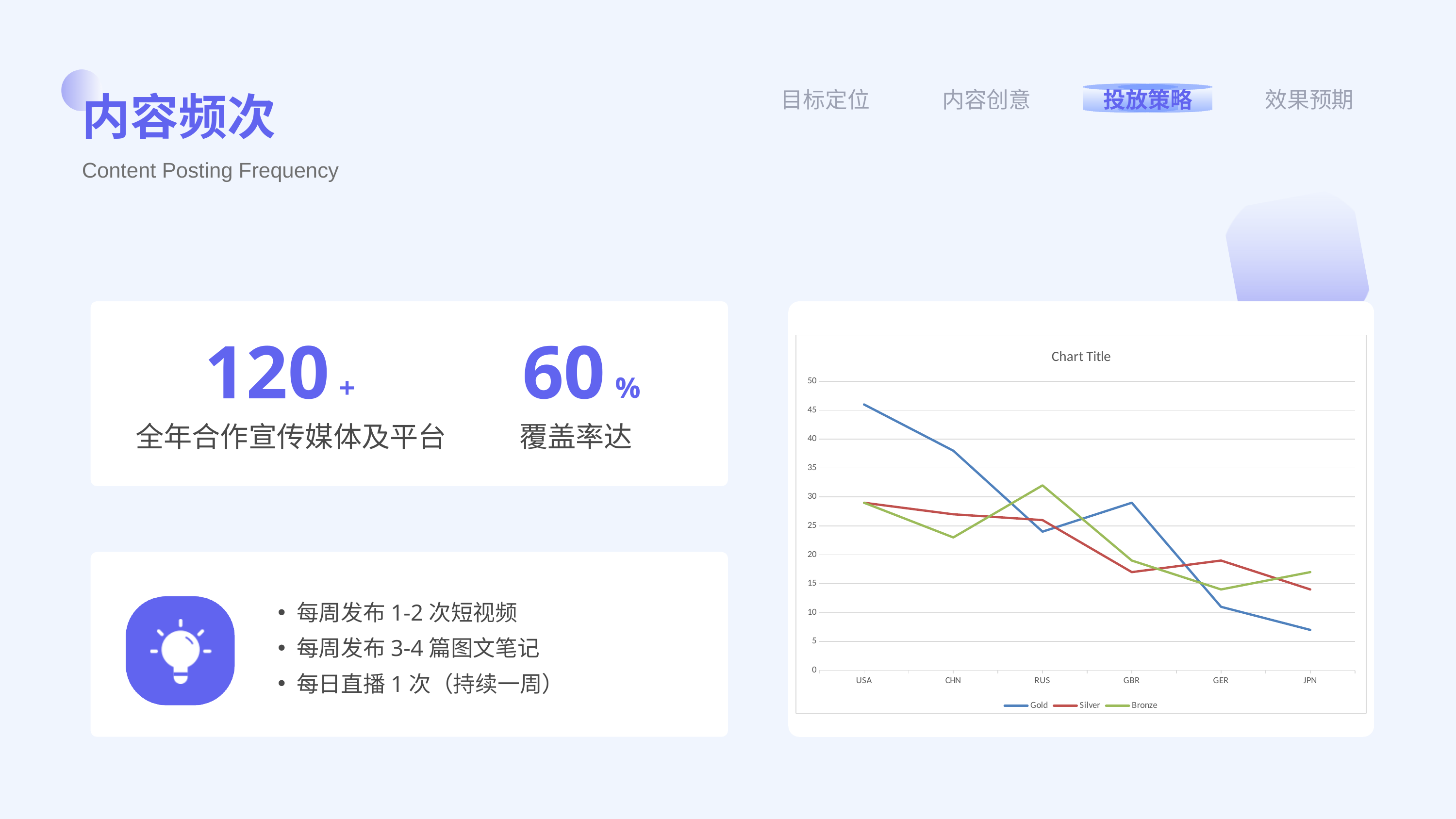
Does the Gold line generally rise or fall from USA to JPN? fall Is the Gold value for USA greater or less than 40? greater Which category has the highest Bronze value? RUS Which category has the lowest Gold value? JPN Is the Bronze value for RUS greater or less than 30? greater How many categories are shown on the x axis of the chart? 6 What kind of chart is shown on the slide? line chart Which category has the highest Gold value? USA How many series does the chart legend list? 3 What is the title shown above the chart? Chart Title Which is larger at GER, the Silver value or the Gold value? Silver Is the Gold value for JPN greater or less than 10? less